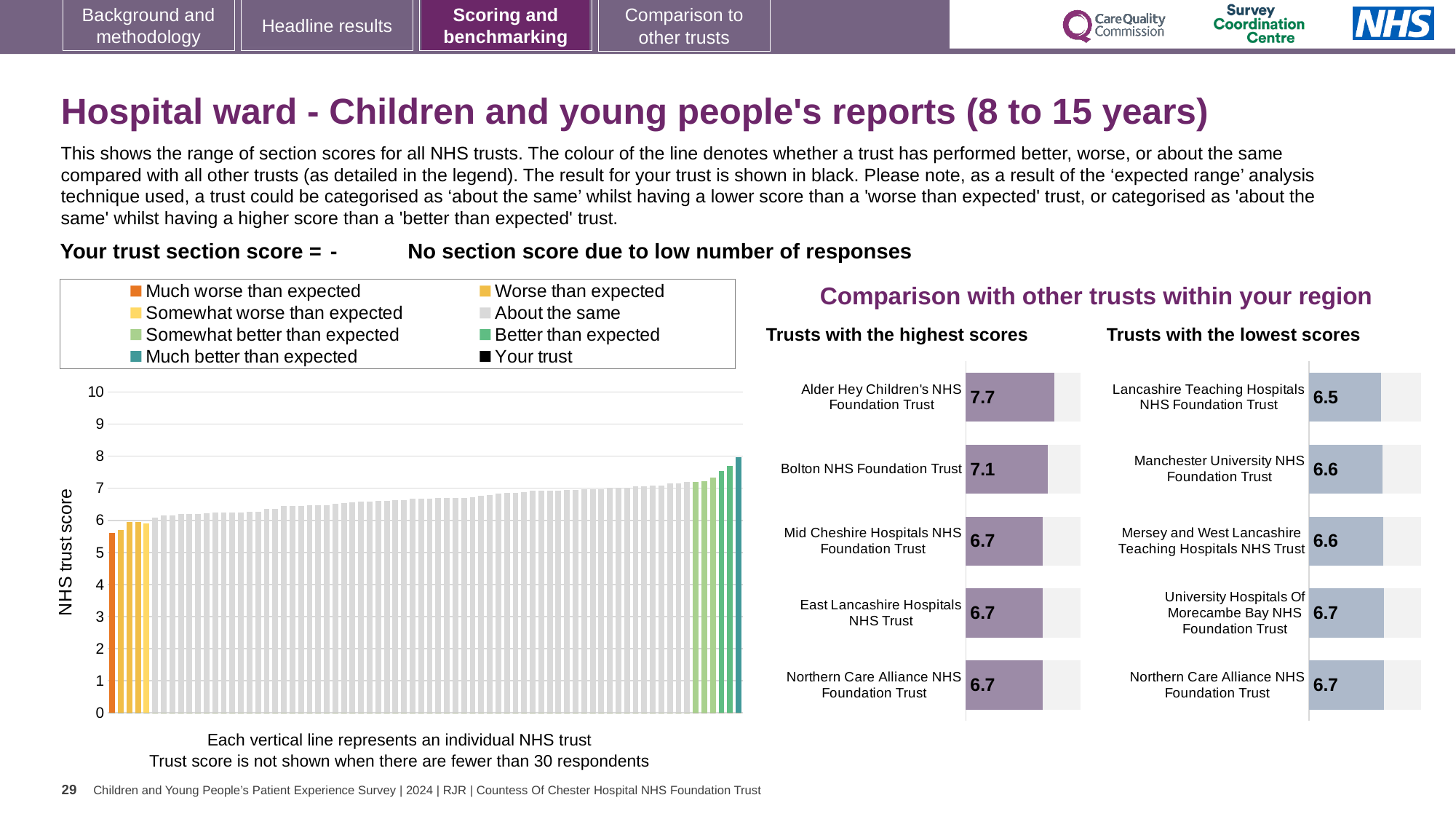
In the 'Trusts with the lowest scores' chart, which trust has the lowest score? Lancashire Teaching Hospitals NHS Foundation Trust In the 'Trusts with the lowest scores' chart, what is the score for Manchester University NHS Foundation Trust? 6.6 In the 'NHS trust score' chart on the left, do the bar values rise or fall from left to right? Rise In the 'Trusts with the highest scores' chart, which trust has the highest score? Alder Hey Children's NHS Foundation Trust What kind of chart is the 'NHS trust score' chart on the left of the slide? Bar chart How many trusts are shown in the 'Trusts with the lowest scores' chart? 5 In the 'NHS trust score' chart on the left, is the value of the leftmost (orange) bar greater or less than 6? less In the 'Trusts with the lowest scores' chart, what is the score for Lancashire Teaching Hospitals NHS Foundation Trust? 6.5 In the 'Trusts with the highest scores' chart, what is the score for Alder Hey Children's NHS Foundation Trust? 7.7 In the 'Trusts with the highest scores' chart, what is the difference between the scores of Alder Hey Children's NHS Foundation Trust and Bolton NHS Foundation Trust? 0.6 In the 'Trusts with the highest scores' chart, which has the larger score: Bolton NHS Foundation Trust or Mid Cheshire Hospitals NHS Foundation Trust? Bolton NHS Foundation Trust In the 'Trusts with the highest scores' chart, what is the score for Bolton NHS Foundation Trust? 7.1